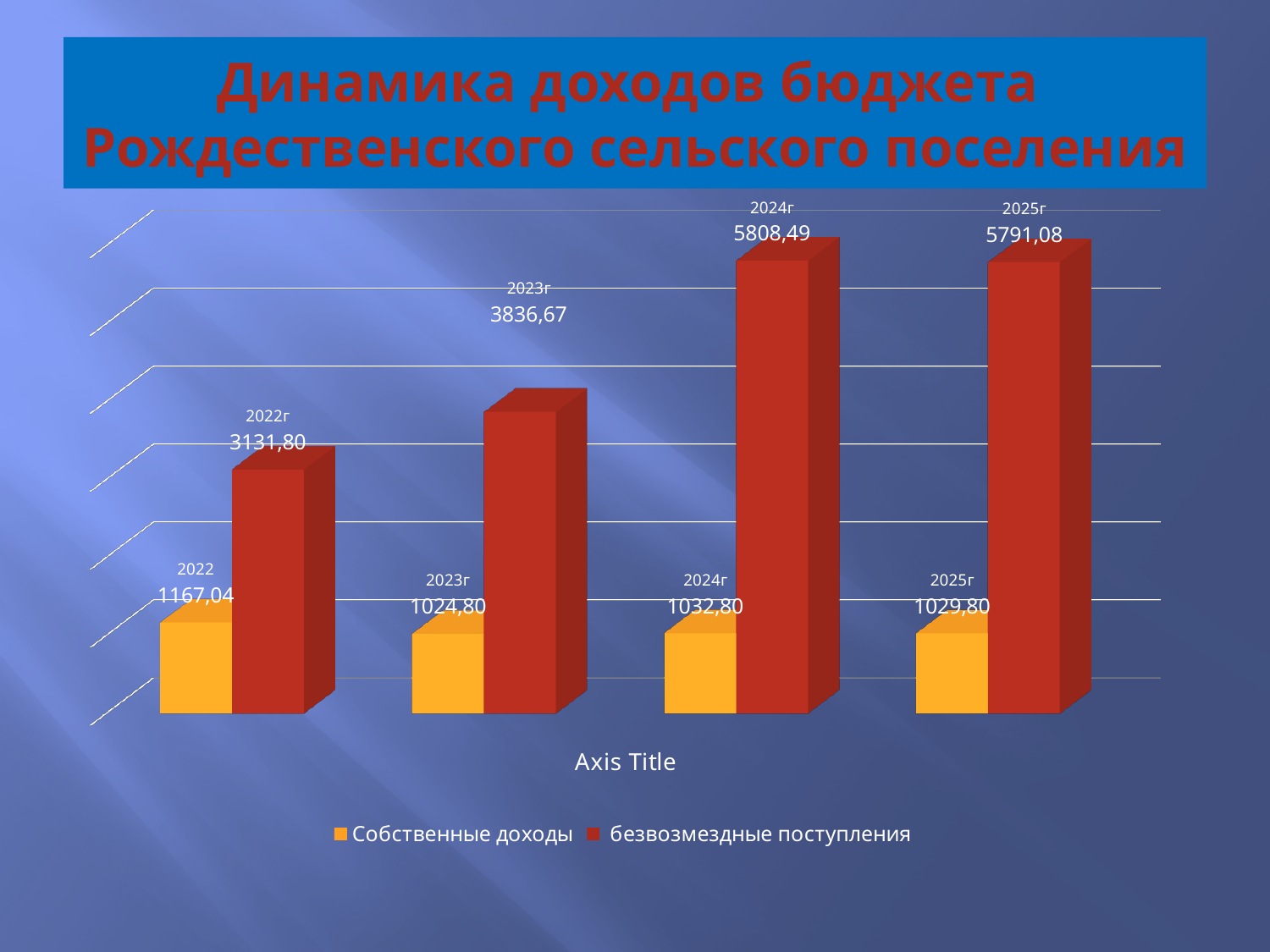
What is the value of безвозмездные поступления for 2024г? 5808,49 How many years are shown on the x axis? 4 What is the difference between безвозмездные поступления in 2024г and 2025г? 17,41 In which year is Собственные доходы highest? 2022 What is the value of безвозмездные поступления for 2023г? 3836,67 Which is larger: Собственные доходы in 2022 or in 2023г? 2022 In which year is безвозмездные поступления lowest? 2022г What is the value of Собственные доходы for 2022? 1167,04 What kind of chart is shown on the slide? bar chart In which year is безвозмездные поступления highest? 2024г How many series does the legend list? 2 What is the value of Собственные доходы for 2025г? 1029,80